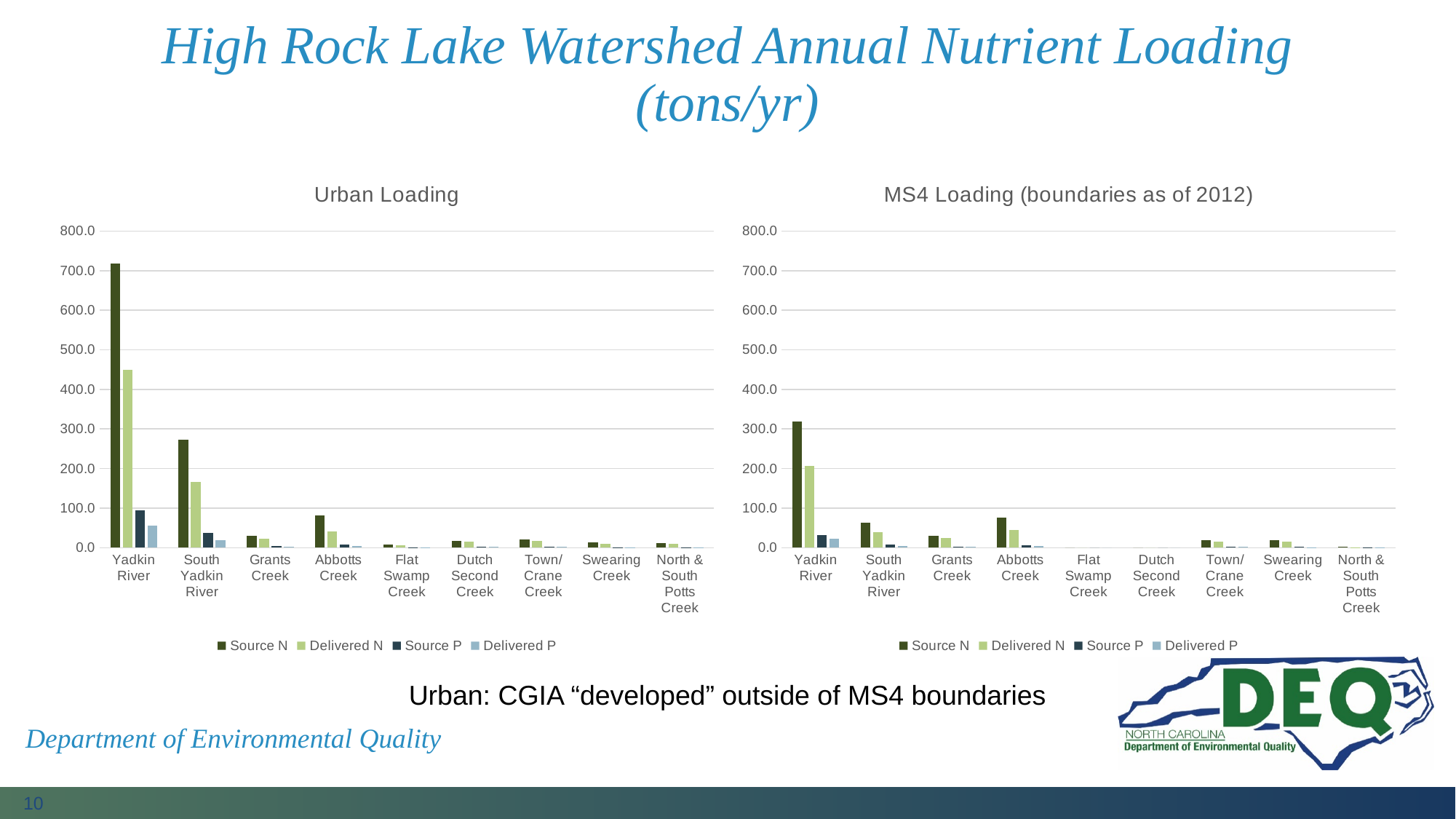
Which is larger: the Source N value for Yadkin River in the Urban Loading chart or in the MS4 Loading chart? Urban Loading In the MS4 Loading chart, is the Delivered N value for Yadkin River greater or less than 100.0? greater What is the title of the chart on the right side of the slide? MS4 Loading (boundaries as of 2012) In the Urban Loading chart, is the Delivered N value for Yadkin River greater or less than 400.0? greater In the MS4 Loading chart, is the Source N value for Yadkin River greater or less than 400.0? less In the Urban Loading chart, which is larger: the Source N value for South Yadkin River or for Abbotts Creek? South Yadkin River How many series does the legend of the MS4 Loading chart list? 4 In the Urban Loading chart, which category has the highest Source N value? Yadkin River In the MS4 Loading chart, which category has the highest Source N value? Yadkin River What kind of chart is the Urban Loading chart? bar chart How many categories are shown on the x axis of the Urban Loading chart? 9